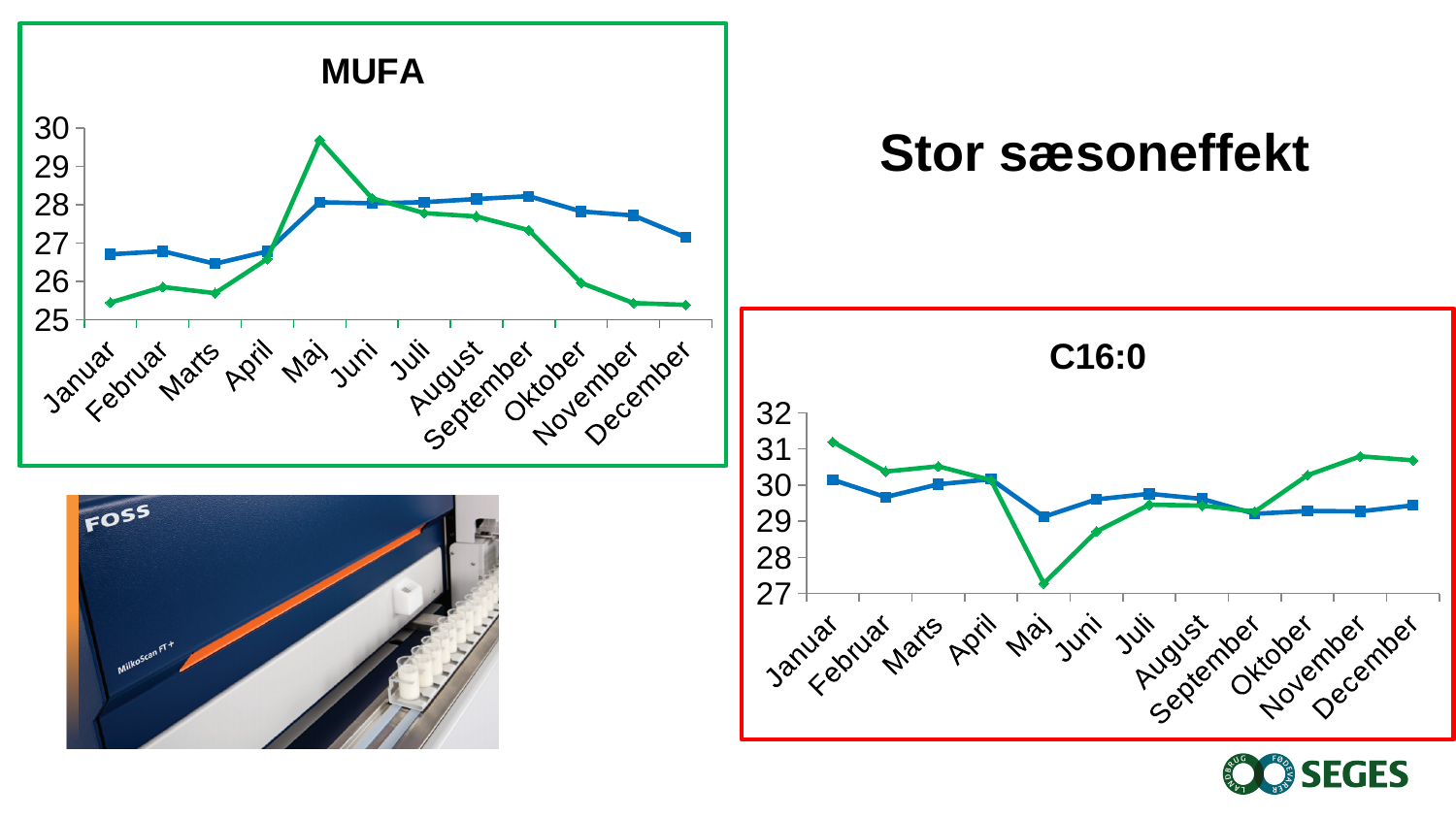
In the MUFA chart, in Maj, which line has the higher value, the green line or the blue line? the green line In the C16:0 chart, in Maj, which line has the higher value, the green line or the blue line? the blue line In the C16:0 chart, does the green line rise or fall from Maj to November? rise In the MUFA chart, is the green line's value in Januar greater or less than 26? less In the C16:0 chart, is the green line's value in Maj greater or less than 28? less In the MUFA chart, in which month does the green line reach its highest value? Maj How many months are shown on the x axis of the MUFA chart? 12 How many lines are plotted in the C16:0 chart? 2 What kind of chart is the MUFA chart? line chart In the MUFA chart, is the green line's value in Maj greater or less than 29? greater In the C16:0 chart, in which month does the green line reach its lowest value? Maj What kind of chart is the C16:0 chart? line chart